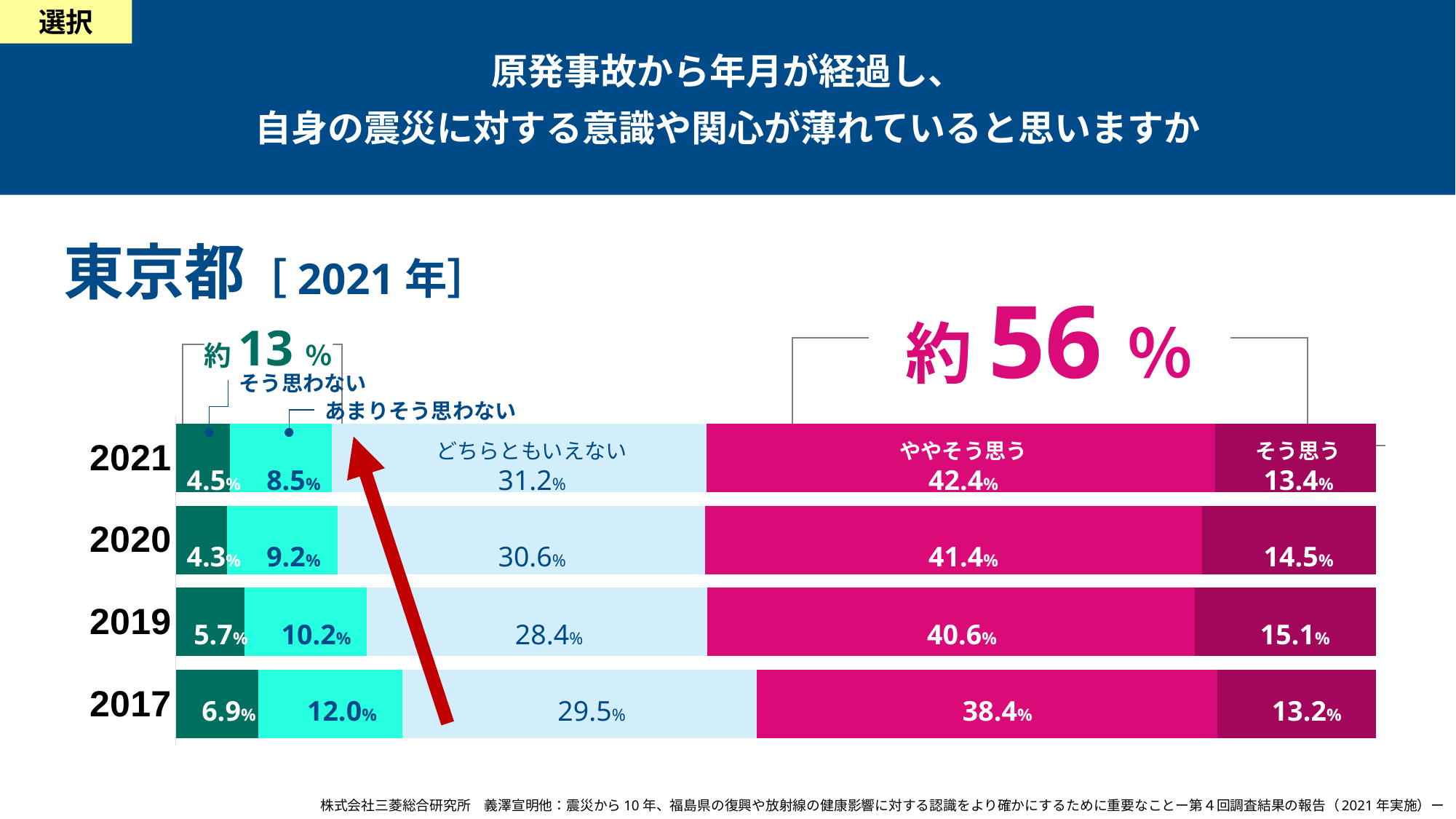
What is the value for そう思わない in 2017? 6.9% How many response categories make up each stacked bar? 5 How many years are shown in the chart? 4 What is the difference between the そう思う values for 2020 and 2017? 1.3% What is the value for どちらともいえない in 2020? 30.6% What is the combined value of そう思わない and あまりそう思わない in 2021? 13.0% Which year has the highest value for ややそう思う? 2021 What is the value for そう思う in 2019? 15.1% What type of chart is shown on the slide? Stacked bar chart What is the value for ややそう思う in 2021? 42.4% Which is larger, the どちらともいえない value for 2021 or for 2019? 2021 Which year has the lowest value for あまりそう思わない? 2021